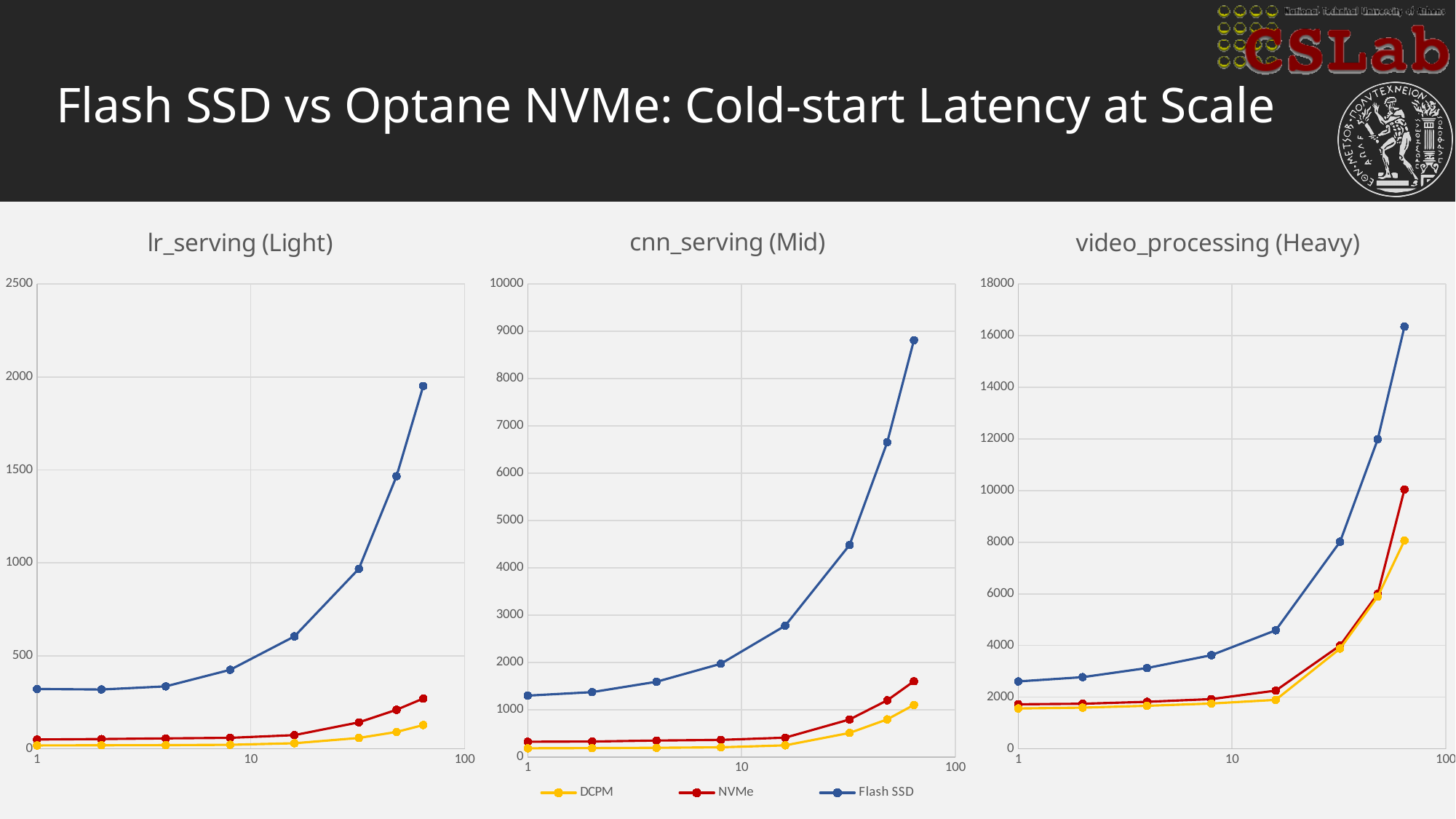
What is the title of the rightmost chart? video_processing (Heavy) What kind of chart is the lr_serving (Light) chart? line chart How many data points does the Flash SSD series have in the cnn_serving (Mid) chart? 8 In the video_processing (Heavy) chart, which series has the lowest value at the rightmost point? DCPM In the cnn_serving (Mid) chart, is the rightmost Flash SSD value greater or less than 8000? greater In the video_processing (Heavy) chart, is the rightmost Flash SSD value greater or less than 14000? greater In the lr_serving (Light) chart, which series has the highest value at the rightmost point? Flash SSD Which series does the legend list in blue? Flash SSD In the video_processing (Heavy) chart, do the Flash SSD values rise or fall along the x axis? rise In the cnn_serving (Mid) chart, which is larger at the rightmost point: NVMe or DCPM? NVMe In the lr_serving (Light) chart, is the rightmost Flash SSD value greater or less than 1500? greater How many series does the legend list? 3